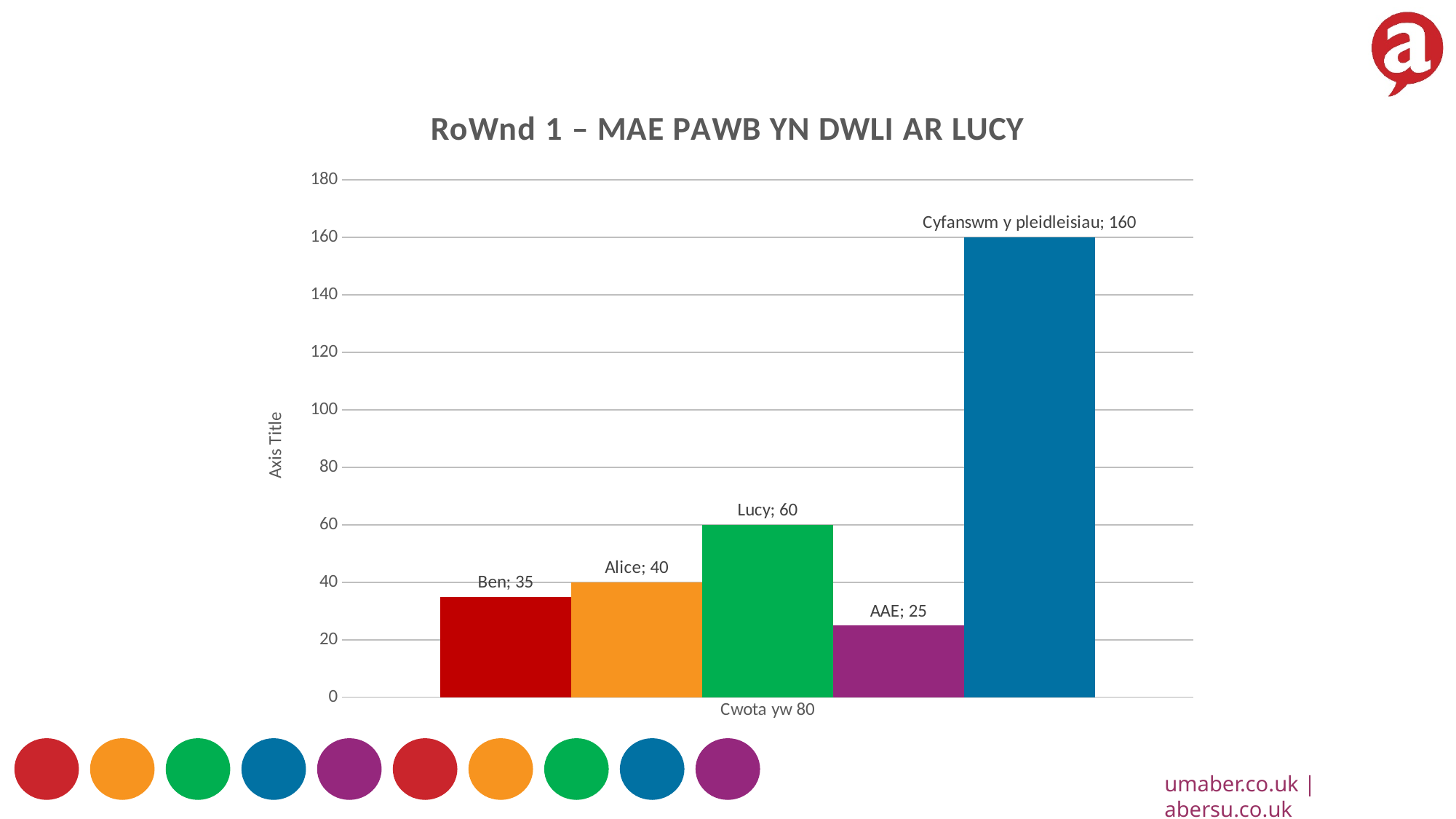
What is the value for AAE? 25 How many bars are plotted on the chart? 5 What kind of chart is shown on the slide? bar chart Which bar has the highest value? Cyfanswm y pleidleisiau Which is larger, the value for Ben or the value for Alice? Alice What is the value for Lucy? 60 What is the difference between the values for Lucy and Alice? 20 Which bar has the lowest value? AAE What is the title of the chart? RoWnd 1 – MAE PAWB YN DWLI AR LUCY What is the value labelled 'Cyfanswm y pleidleisiau'? 160 What is the label shown on the horizontal axis of the chart? Cwota yw 80 What is the value for Ben? 35